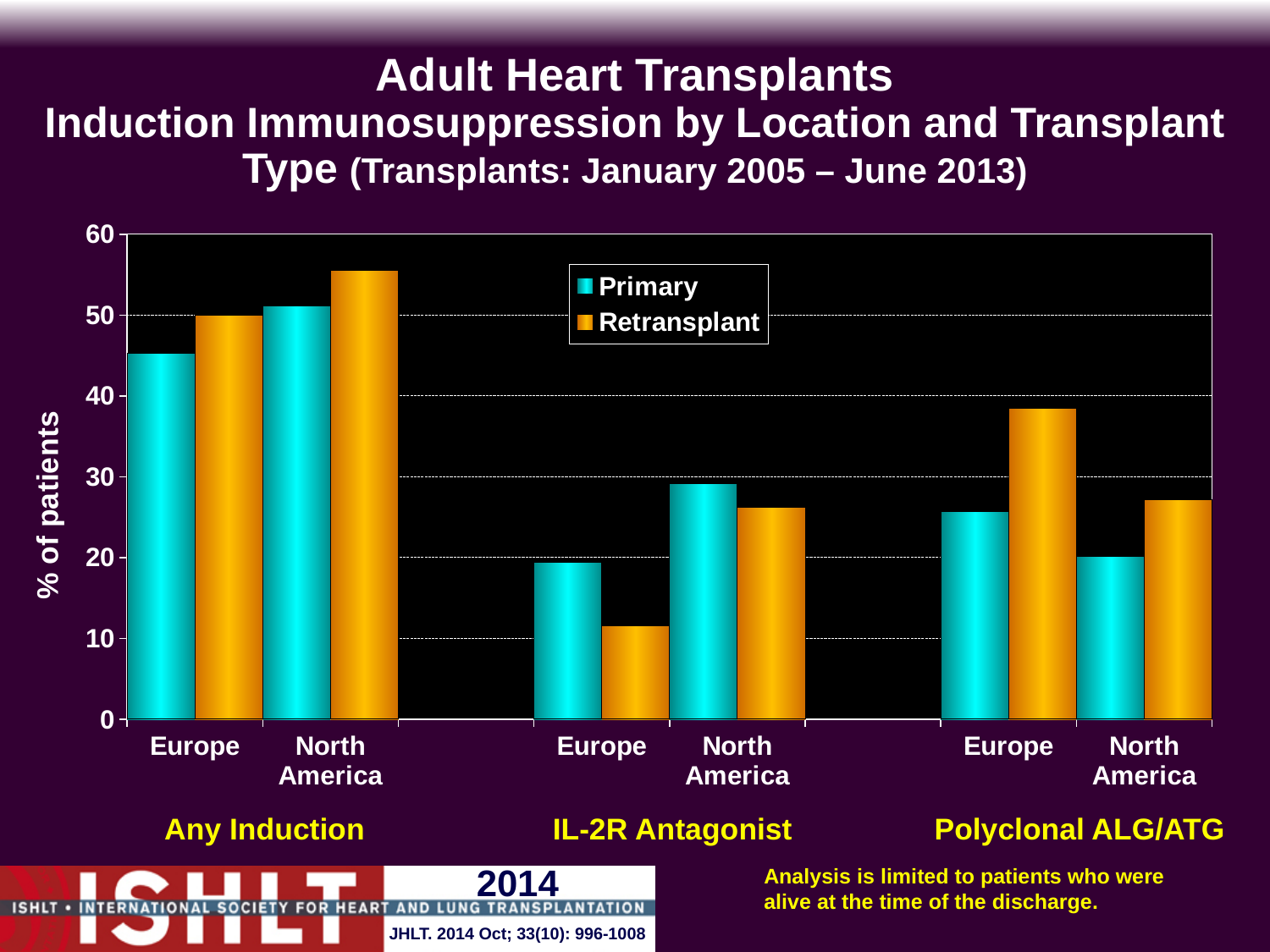
How many location categories (Europe / North America groups) are plotted across all three induction types? 6 Is the Primary value for Europe under Any Induction greater or less than 40? greater Under IL-2R Antagonist for Europe, which is larger, the Primary or the Retransplant value? Primary What is the label on the vertical axis? % of patients What are the two series named in the legend? Primary and Retransplant Is the Retransplant value for Europe under IL-2R Antagonist greater or less than 20? less What kind of chart is shown on the slide? bar chart Which bar is the lowest on the whole chart? Retransplant, Europe, IL-2R Antagonist Under Polyclonal ALG/ATG for Europe, which is larger, the Primary or the Retransplant value? Retransplant Is the Retransplant value for North America under Any Induction greater or less than 50? greater How many series does the legend list? 2